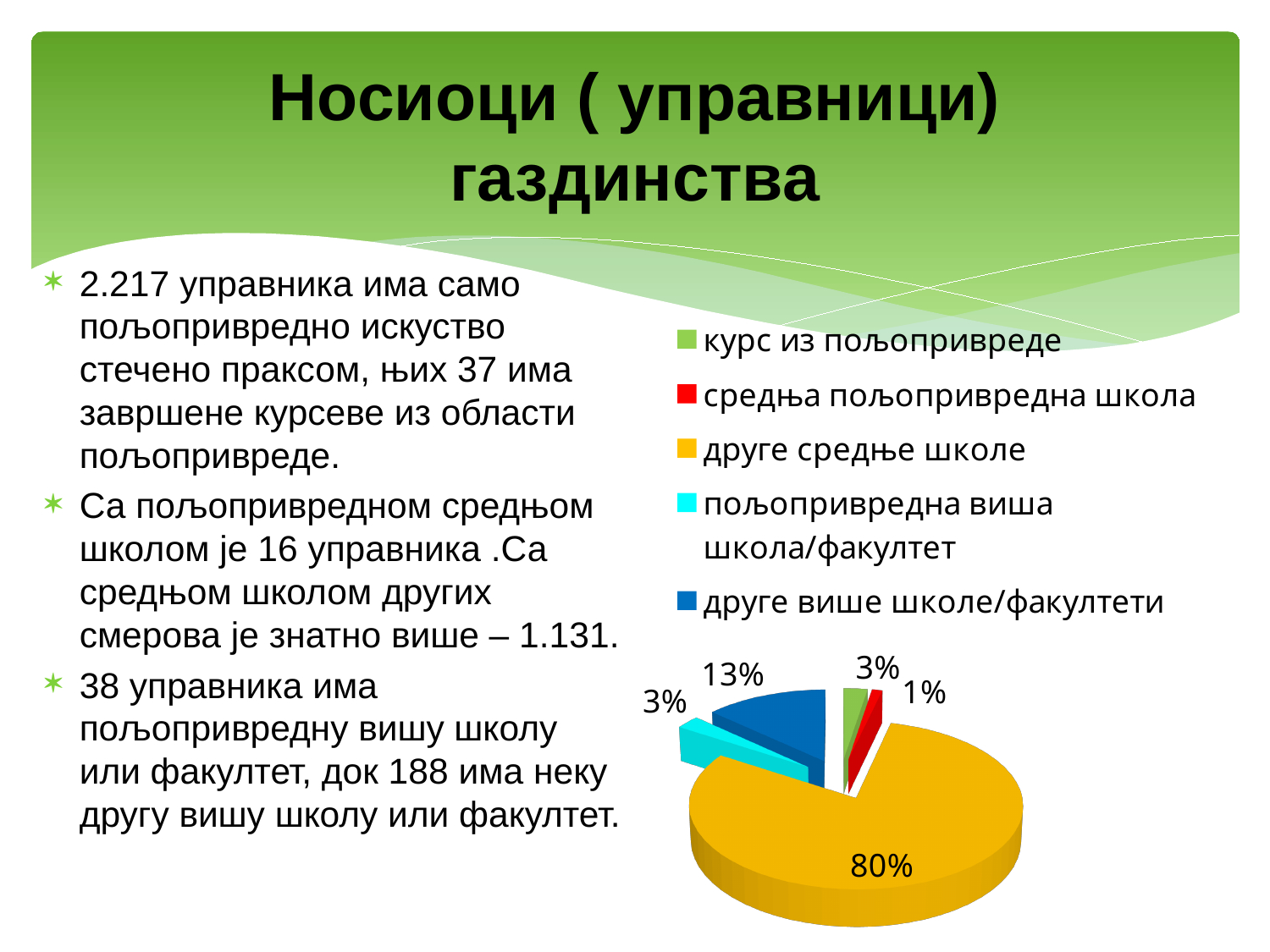
What kind of chart is shown on the slide? Pie chart Which is larger: the slice for "друге више школе/факултети" or the slice for "пољопривредна виша школа/факултет"? друге више школе/факултети What share of the pie does "друге више школе/факултети" represent? 13% What share of the pie does "средња пољопривредна школа" represent? 1% What share of the pie does "курс из пољопривреде" represent? 3% Which category has the largest slice of the pie? друге средње школе What share of the pie does "пољопривредна виша школа/факултет" represent? 3% What colour is the slice for "друге више школе/факултети"? Blue What is the difference in percentage points between the "друге средње школе" slice and the "друге више школе/факултети" slice? 67 percentage points What share of the pie does "друге средње школе" represent? 80% How many categories does the pie chart show? 5 Which category has the smallest slice of the pie? средња пољопривредна школа